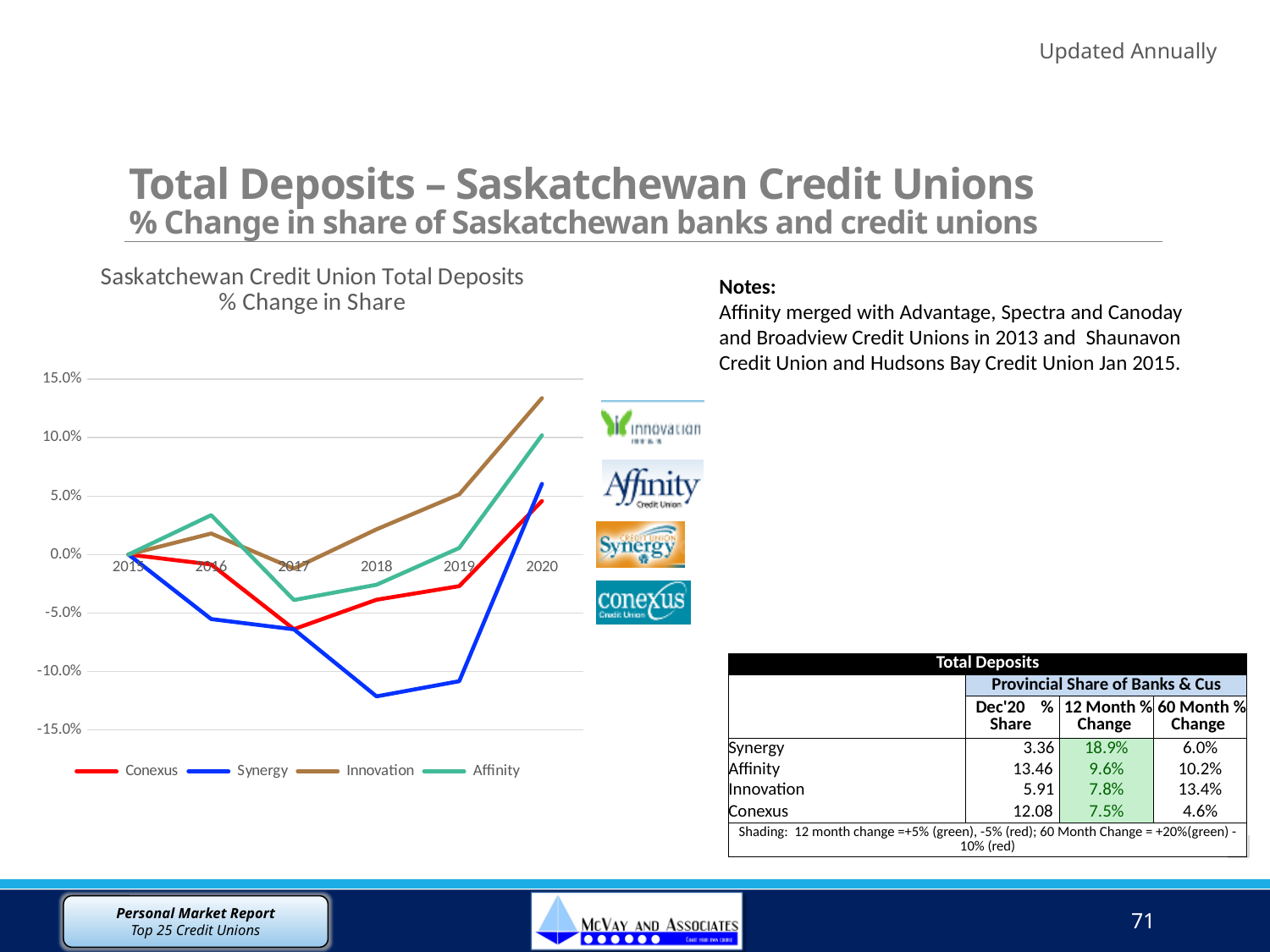
Is the value for Synergy in 2018 greater or less than -10.0%? less Which credit union has the highest % change in share in 2020? Innovation What colour is the Synergy line in the chart? blue What kind of chart is shown on the slide? line chart Is the value for Innovation in 2020 greater or less than 10.0%? greater Does the Synergy line rise or fall from 2015 to 2018? fall Which credit union has the lowest % change in share in 2018? Synergy In 2016, which is larger: the value for Affinity or the value for Synergy? Affinity Is the value for Conexus in 2017 greater or less than -5.0%? less How many years are shown along the x axis of the chart? 6 How many series does the legend of the chart list? 4 In 2020, which is larger: the value for Innovation or the value for Affinity? Innovation